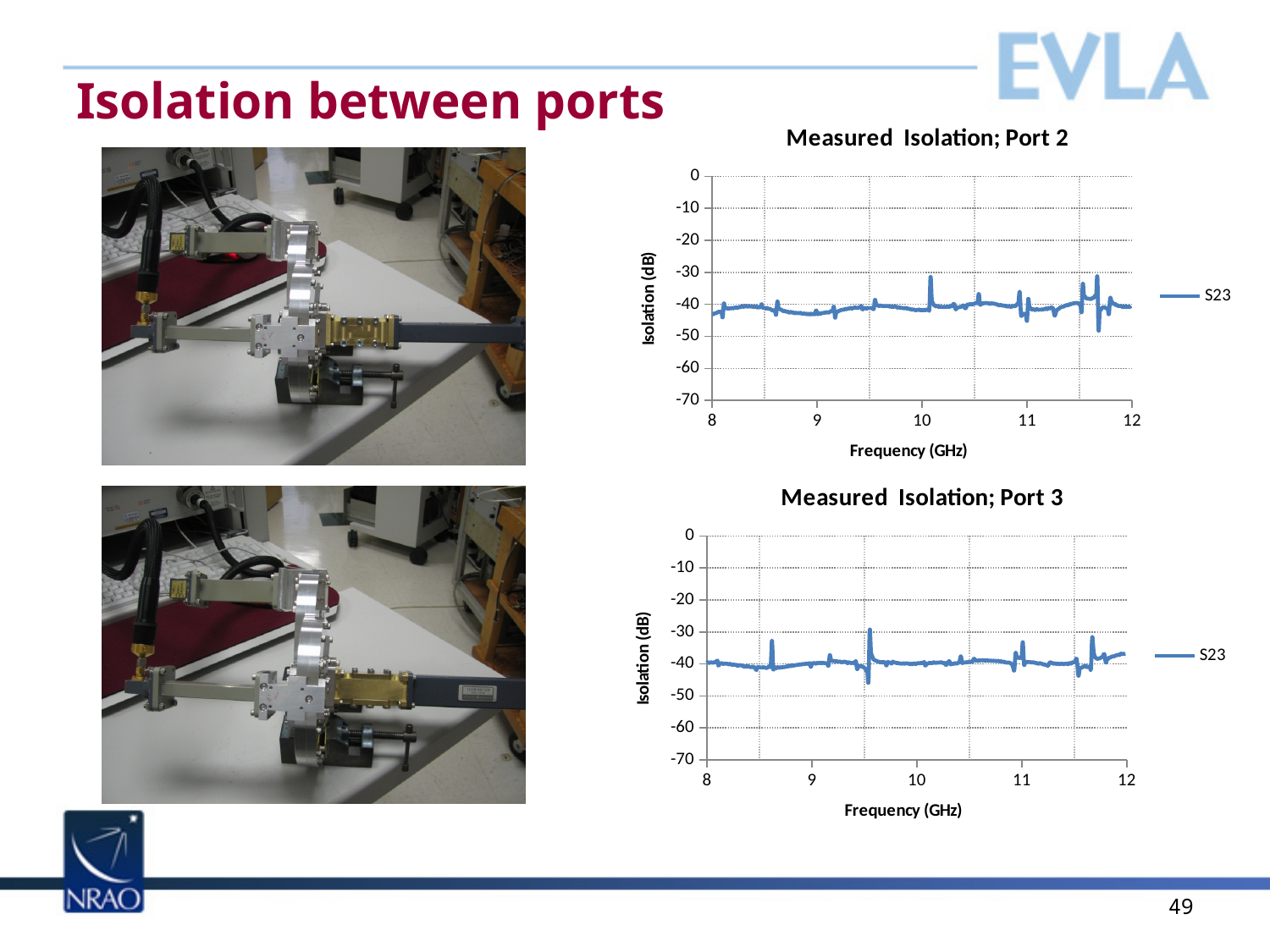
What is the x-axis label of the "Measured Isolation; Port 2" chart? Frequency (GHz) How many series does the legend of the "Measured Isolation; Port 2" chart list? 1 What kind of chart is the "Measured Isolation; Port 3" chart? line chart In the "Measured Isolation; Port 2" chart, is the S23 value at 10 GHz greater or less than -60? greater How many series does the legend of the "Measured Isolation; Port 3" chart list? 1 In the "Measured Isolation; Port 3" chart, is the S23 value at 11 GHz greater or less than -20? less In the "Measured Isolation; Port 2" chart, is the S23 value at 9 GHz greater or less than -20? less What is the name of the series shown in the legend of the "Measured Isolation; Port 3" chart? S23 What kind of chart is the "Measured Isolation; Port 2" chart? line chart